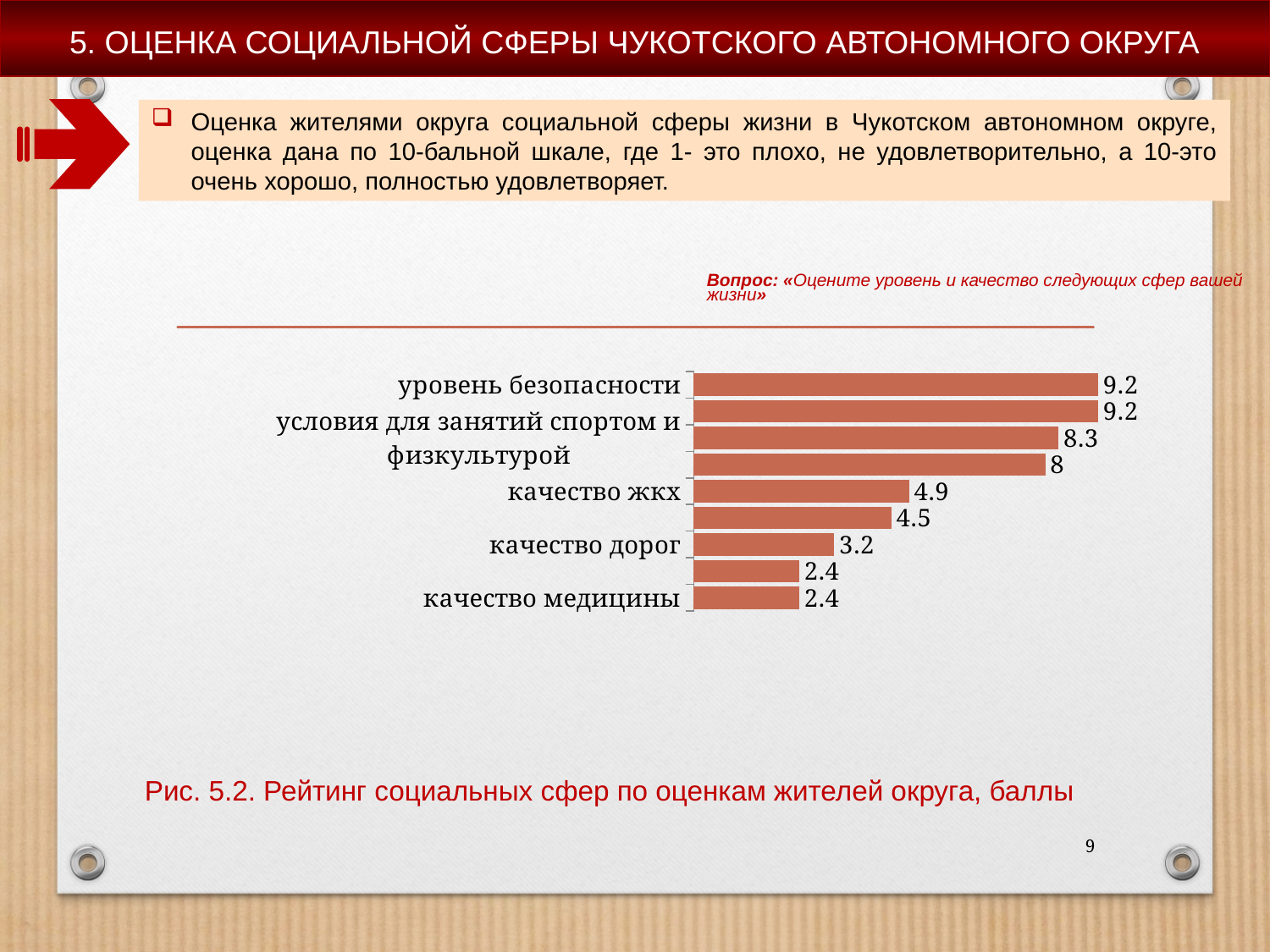
What is the value for условия для занятий спортом и физкультурой? 8.3 What kind of chart is shown on the slide? bar chart How many bars are plotted on the chart? 9 What is the value for уровень безопасности? 9.2 What is the value for качество жкх? 4.9 What is the highest value shown on the chart? 9.2 Which is larger, the value for качество жкх or the value for качество дорог? качество жкх What is the lowest value shown on the chart? 2.4 What is the value for качество дорог? 3.2 What is the caption of the chart given below it? Рис. 5.2. Рейтинг социальных сфер по оценкам жителей округа, баллы What is the value for качество медицины? 2.4 What is the difference between the values for уровень безопасности and качество медицины? 6.8